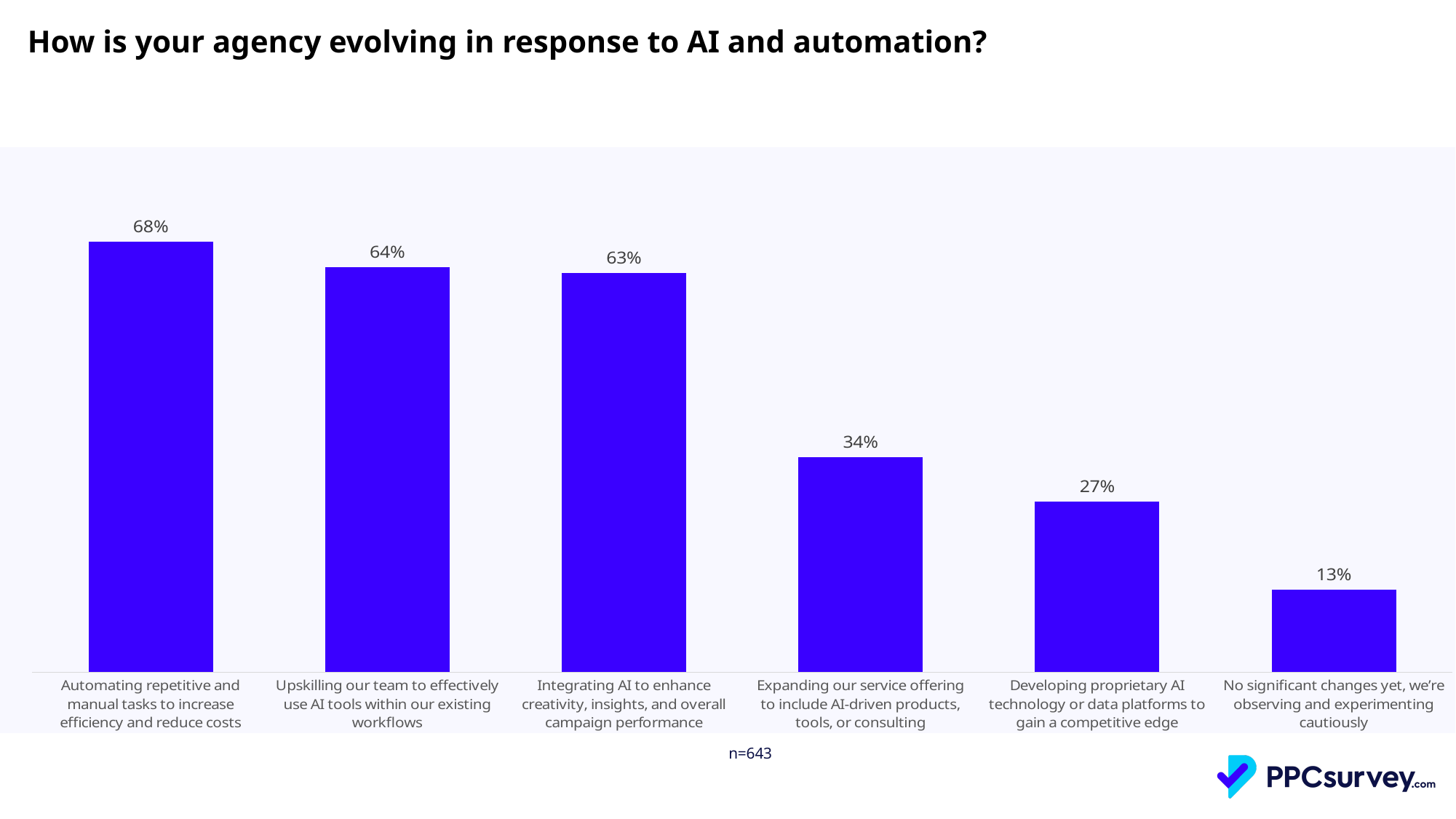
How many categories are shown in the chart? 6 What percentage is shown for 'No significant changes yet, we're observing and experimenting cautiously'? 13% Do the values rise or fall from left to right across the chart? Fall What is the difference between the values for 'Upskilling our team to effectively use AI tools within our existing workflows' and 'Developing proprietary AI technology or data platforms to gain a competitive edge'? 37% Which category has the highest value? Automating repetitive and manual tasks to increase efficiency and reduce costs What kind of chart is shown on the slide? Bar chart Which category has the lowest value? No significant changes yet, we're observing and experimenting cautiously What percentage of respondents selected 'Automating repetitive and manual tasks to increase efficiency and reduce costs'? 68% What is the value for 'Expanding our service offering to include AI-driven products, tools, or consulting'? 34% Which is larger: the value for 'Expanding our service offering to include AI-driven products, tools, or consulting' or for 'Developing proprietary AI technology or data platforms to gain a competitive edge'? Expanding our service offering to include AI-driven products, tools, or consulting What sample size (n) is shown below the chart? n=643 What is the difference between the values for 'Integrating AI to enhance creativity, insights, and overall campaign performance' and 'No significant changes yet, we're observing and experimenting cautiously'? 50%